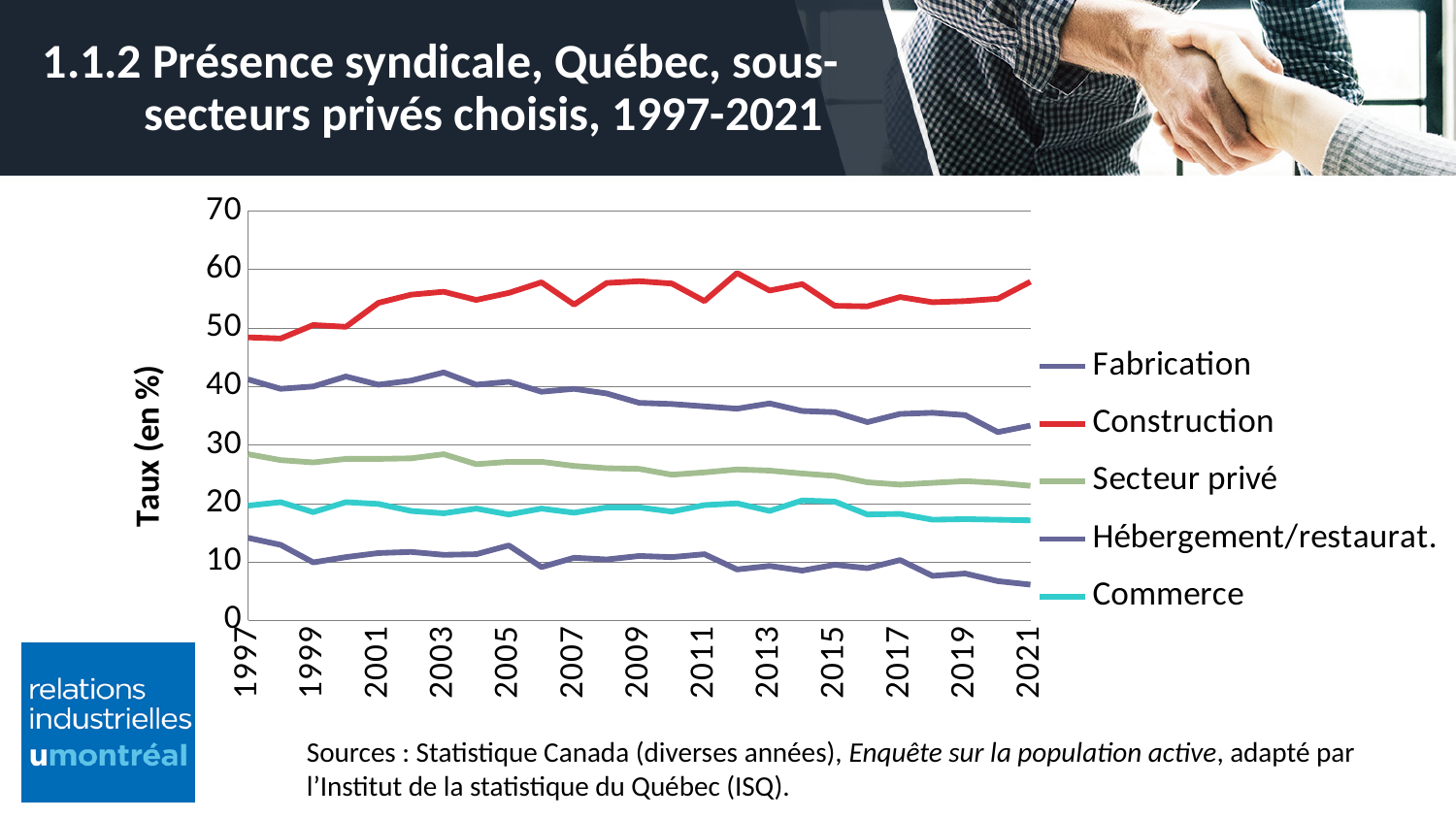
Is the value for Construction in 2021 greater or less than 50? greater What is the label on the vertical axis? Taux (en %) How many series does the legend list? 5 Which series has the highest values across the whole period? Construction Does the Fabrication series rise or fall from 1997 to 2021? fall Which series has the lowest values across the whole period? Hébergement/restaurat. Does the Construction series rise or fall from 1997 to 2021? rise What kind of chart is shown on the slide? line chart Is the value for Hébergement/restaurat. in 2021 greater or less than 10? less Is the value for Fabrication in 2021 greater or less than 40? less In 2021, which is larger: Construction or Secteur privé? Construction